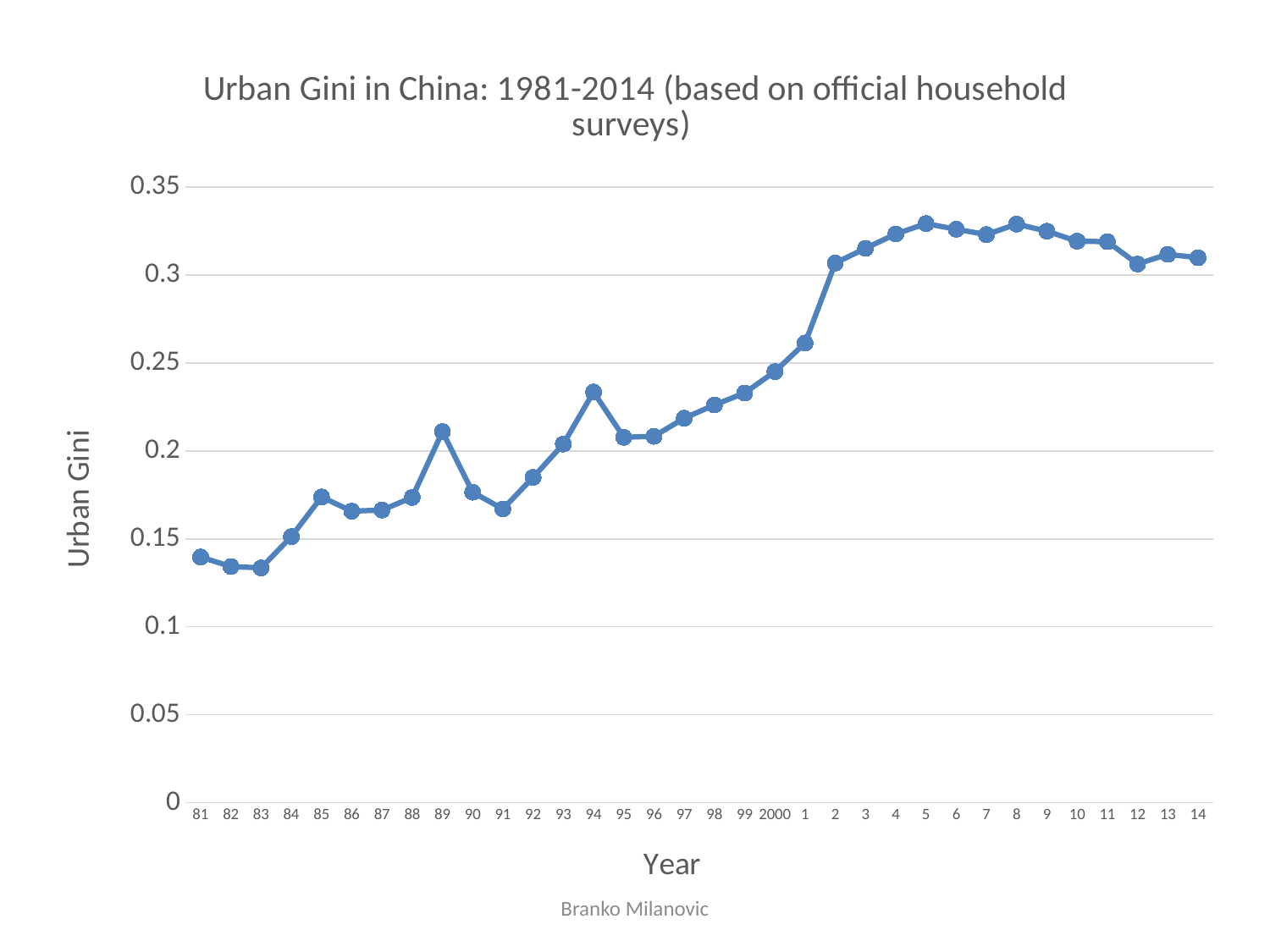
Is the value for 1 (2001) greater or less than 0.25? greater Which is larger, the value for 94 or the value for 95? 94 What is the label on the vertical axis? Urban Gini What is the title of the chart? Urban Gini in China: 1981-2014 (based on official household surveys) What kind of chart is shown on the slide? line chart Which is larger, the value for 89 or the value for 90? 89 Overall, does the Urban Gini rise or fall from 1981 to 2014? rise Is the value for 91 greater or less than 0.2? less Is the value for 81 greater or less than 0.15? less How many data points are plotted on the line? 34